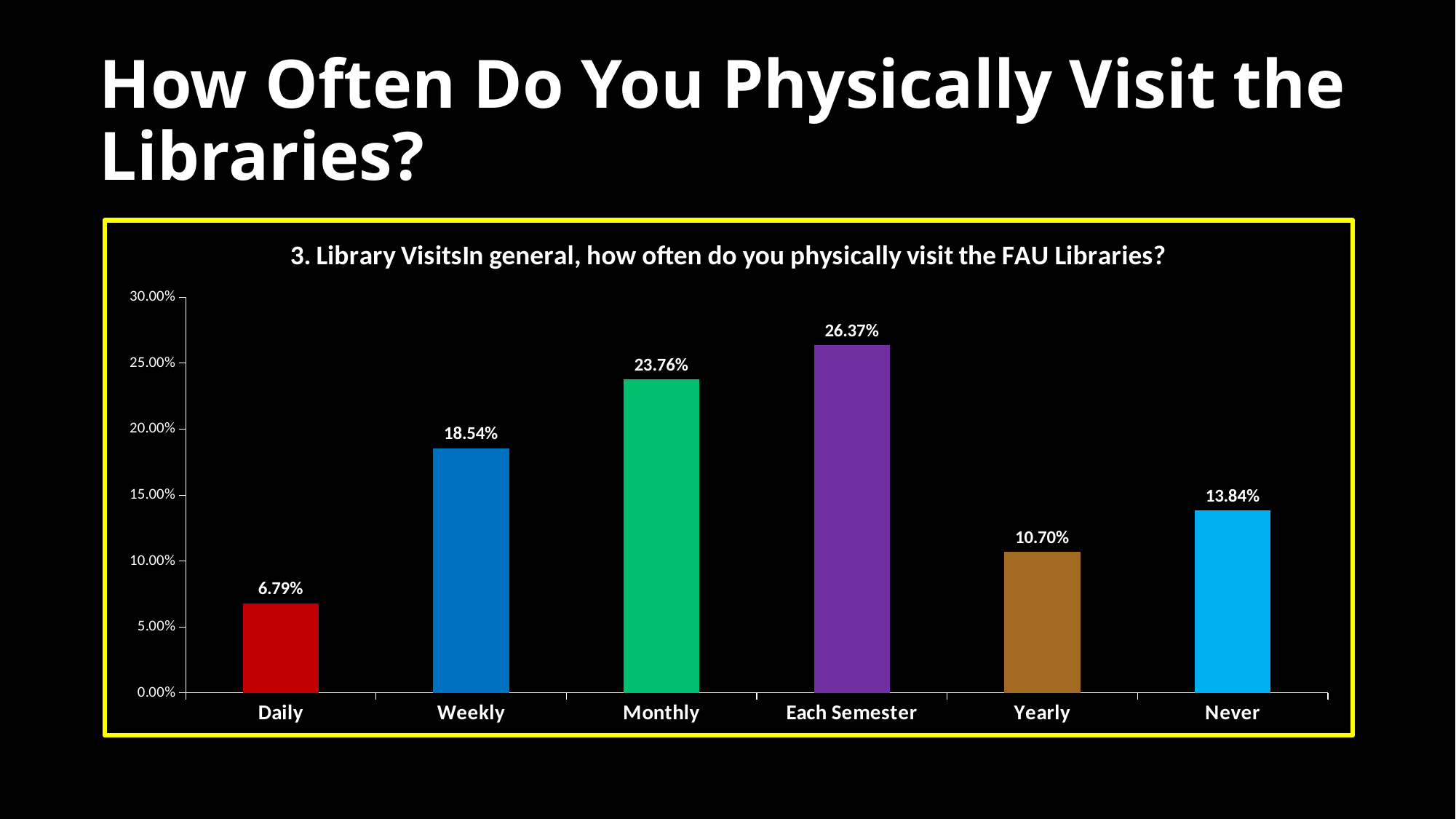
What is the difference between the values for Weekly and Yearly? 7.84% What is the value for Daily? 6.79% What colour is the bar for Each Semester? Purple Which category has the highest value? Each Semester What is the value for Each Semester? 26.37% Which is larger, the value for Never or the value for Yearly? Never What kind of chart is shown on the slide? Bar chart What is the difference between the values for Each Semester and Monthly? 2.61% Is the value for Monthly greater or less than 20.00%? greater What is the value for Never? 13.84% How many categories are shown on the x axis? 6 Which category has the lowest value? Daily